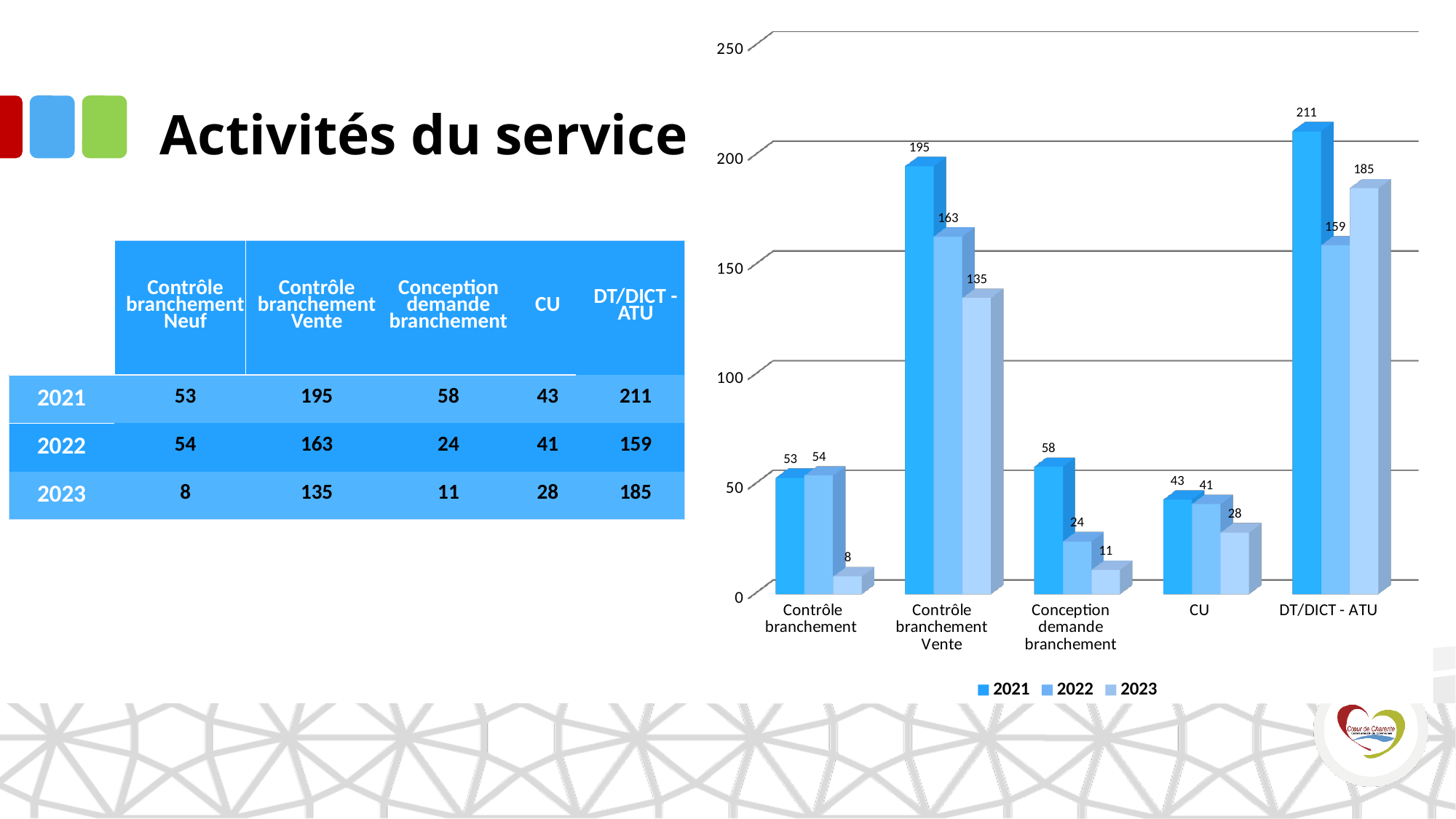
How many categories are shown on the x axis of the chart? 5 How many series does the legend list? 3 Which category has the lowest value in 2023? Contrôle branchement Which category has the highest value in 2021? DT/DICT - ATU What is the value for DT/DICT - ATU in 2023? 185 Is the 2022 value for Contrôle branchement Vente greater or less than 150? greater What kind of chart is shown on the slide? bar chart What is the value for CU in 2022? 41 Which is larger for DT/DICT - ATU: the 2022 value or the 2023 value? 2023 What is the difference between the 2021 and 2023 values for Contrôle branchement Vente? 60 What is the value for Contrôle branchement Vente in 2021? 195 Do the values for Conception demande branchement rise or fall from 2021 to 2023? fall